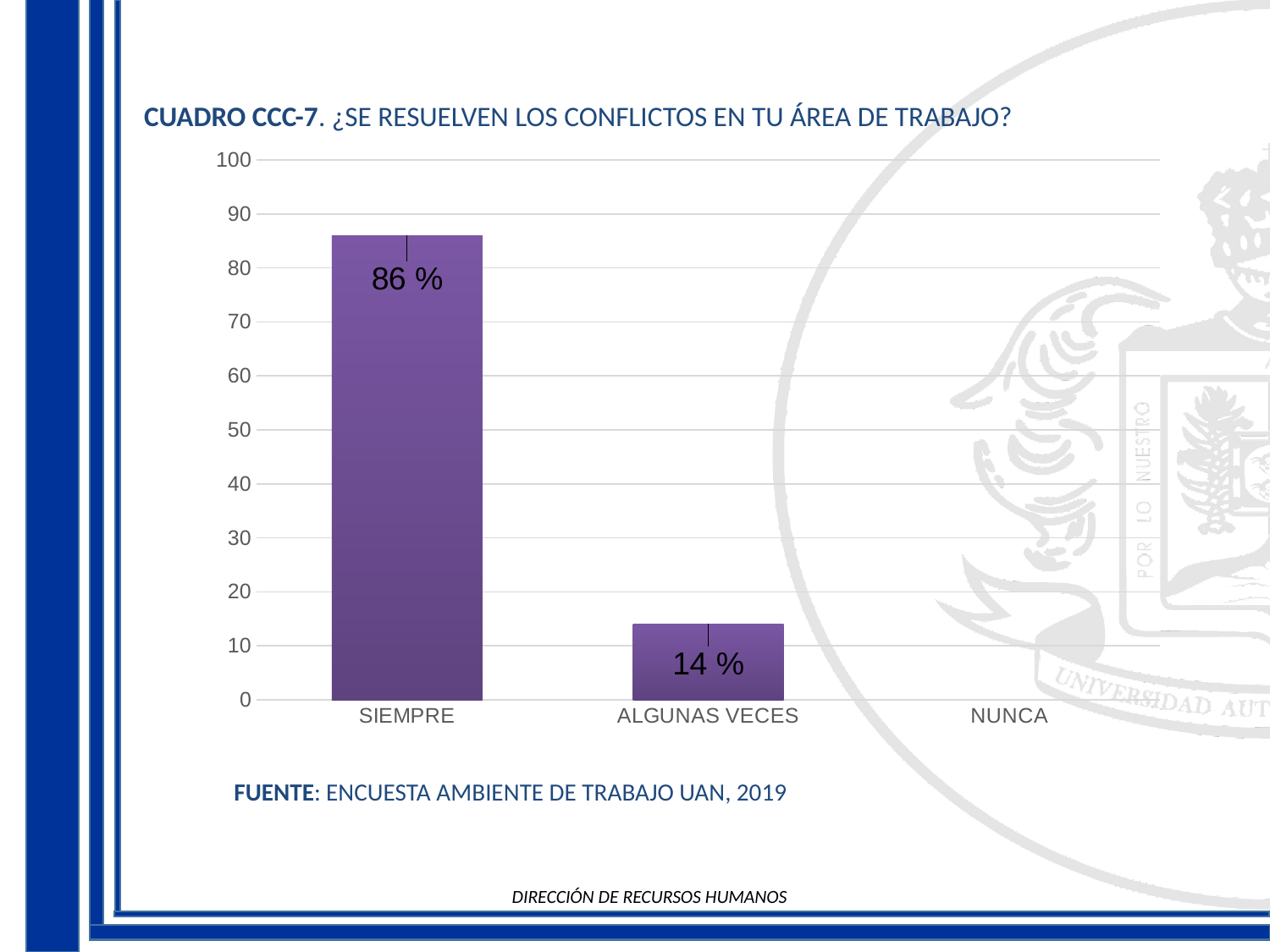
Which category has the highest value? SIEMPRE What is the value for SIEMPRE? 86 % What is the difference between the values for SIEMPRE and ALGUNAS VECES? 72 % Which is larger, the value for SIEMPRE or the value for ALGUNAS VECES? SIEMPRE Is the value for ALGUNAS VECES greater or less than 20? less Do the values rise or fall from SIEMPRE to ALGUNAS VECES? fall How many categories are shown on the x axis? 3 Is the value for SIEMPRE greater or less than 80? greater What is the title of the chart? CUADRO CCC-7. ¿SE RESUELVEN LOS CONFLICTOS EN TU ÁREA DE TRABAJO? What kind of chart is shown on the slide? bar chart What is the maximum value shown on the y axis? 100 What is the value for ALGUNAS VECES? 14 %